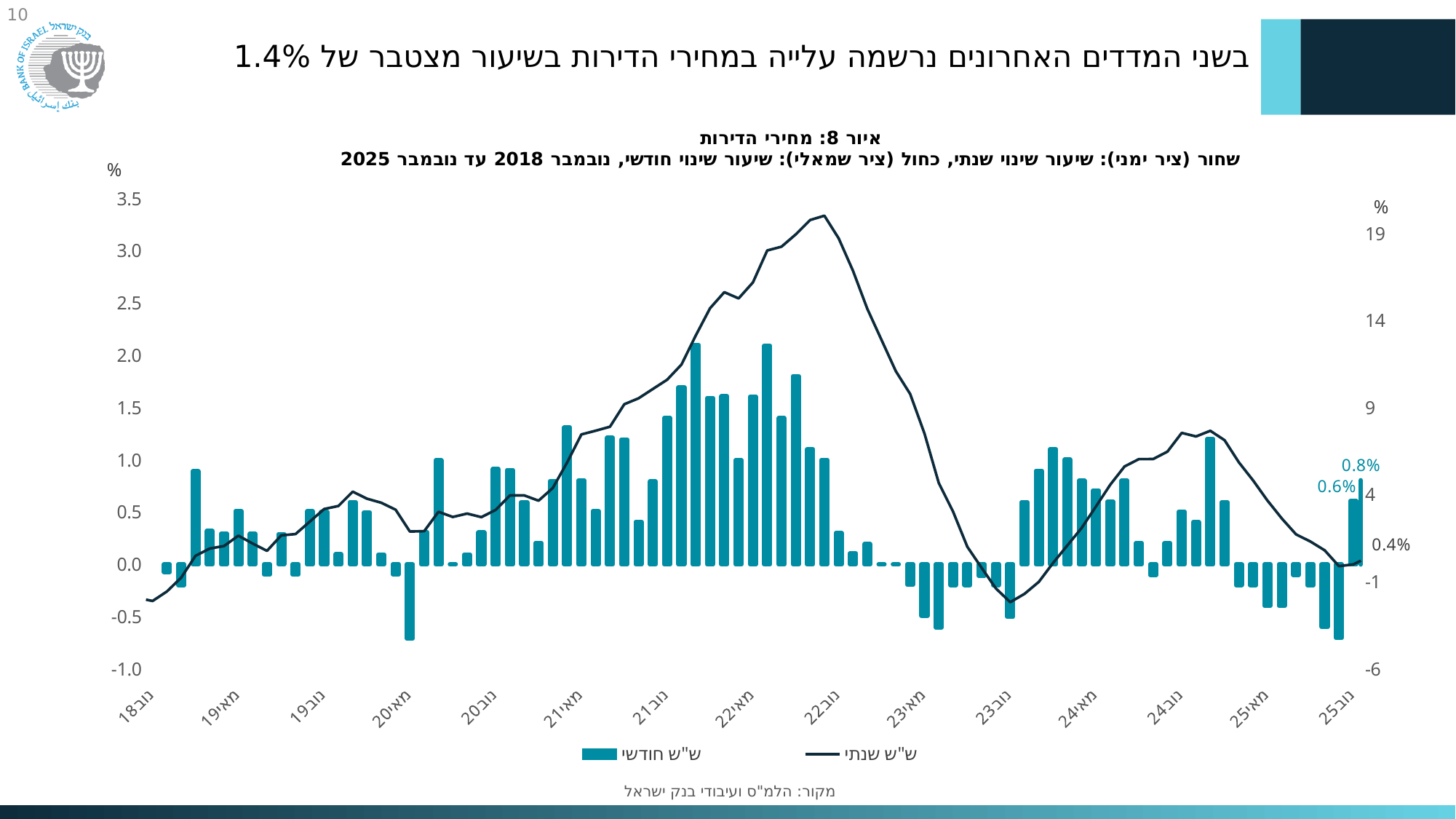
What is the labelled value of the annual change line at the end of the series? 0.4% What is the labelled value of the bar just before the last one for the monthly change? 0.6% Which is larger: the last labelled monthly bar or the one before it? The last bar (0.8%) How many series does the legend list? 2 Is the peak of the annual change line (around late 2022) greater or less than 14 on the right axis? greater Does the annual change line rise or fall between נוב 22 and נוב 23? It falls What kind of chart is shown on the slide? A combined bar and line chart How many date labels are shown on the x axis? 15 What is the title of the chart? איור 8: מחירי הדירות What is the difference between the last two labelled monthly bars, 0.8% and 0.6%? 0.2 percentage points What are the two legend entries of the chart? ש"ש חודשי and ש"ש שנתי What is the labelled value of the last bar (נוב 25) for the monthly change? 0.8%